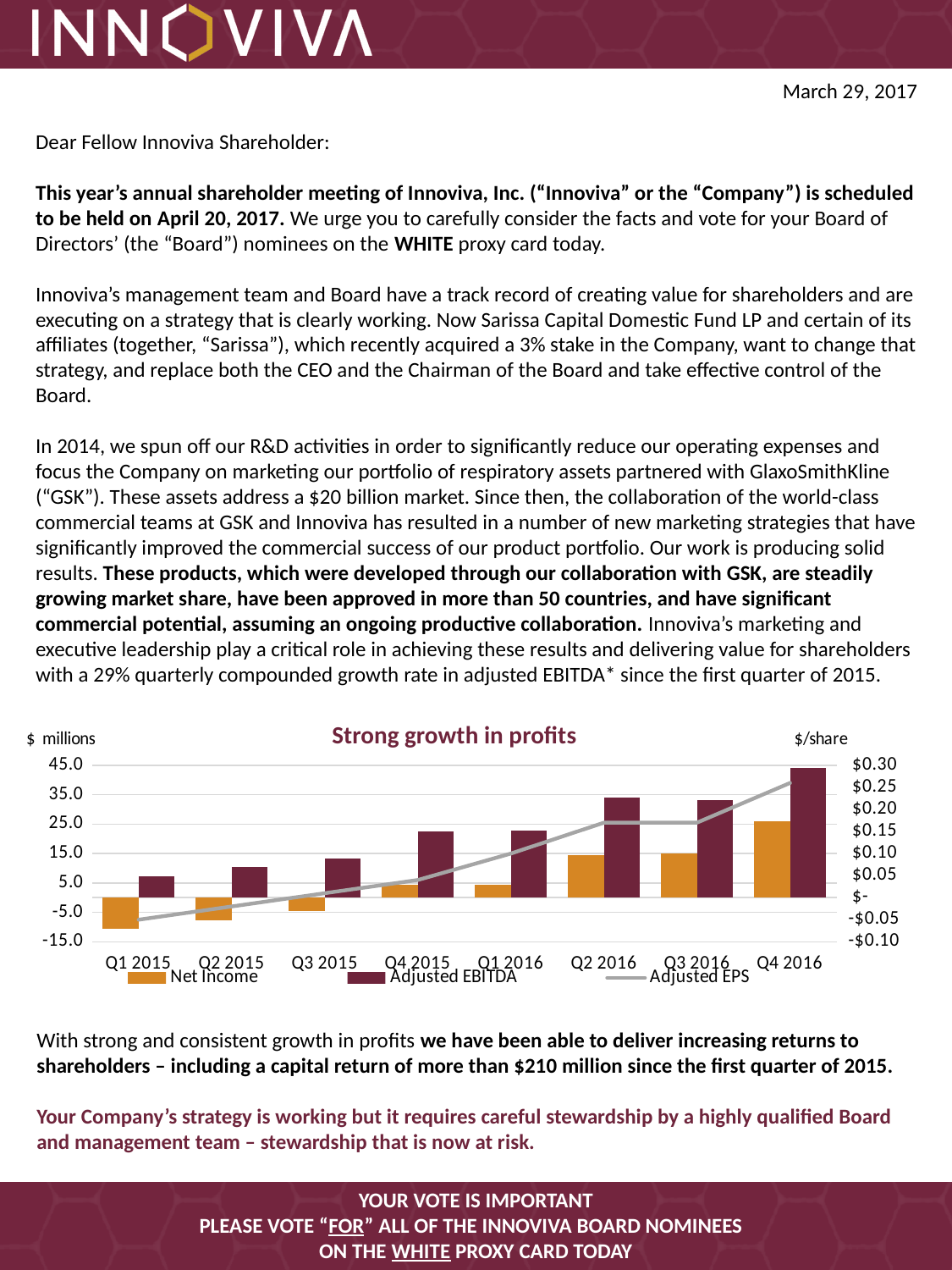
Is the Adjusted EBITDA value for Q4 2016 greater or less than 35.0? greater What kind of chart is shown on the slide? Combined bar and line chart In which quarter is Net Income lowest? Q1 2015 Is the Net Income value for Q4 2016 greater or less than 15.0? greater What is the title of the chart? Strong growth in profits In which quarter is Adjusted EBITDA highest? Q4 2016 Is the Net Income value for Q1 2015 greater or less than -5.0? less Does Adjusted EPS rise or fall from Q1 2015 to Q4 2016? Rise In Q4 2016, which is larger: Net Income or Adjusted EBITDA? Adjusted EBITDA What unit label is shown on the right-hand axis of the chart? $/share How many quarters are shown on the x axis of the chart? 8 How many series does the chart legend list? 3